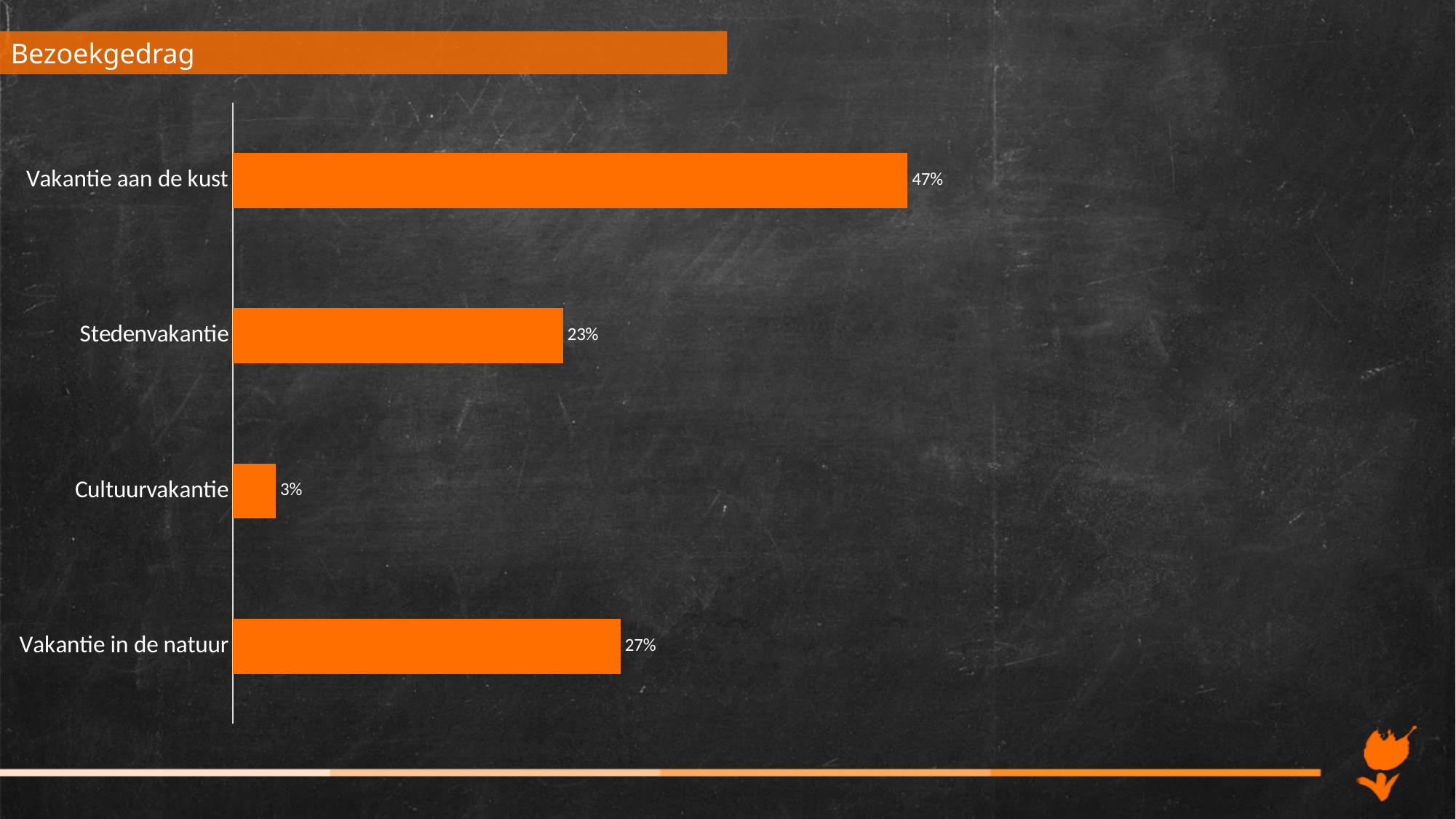
What is the value for Stedenvakantie? 23% What is the difference between the values for Vakantie in de natuur and Cultuurvakantie? 24% What is the title shown at the top of the slide? Bezoekgedrag Which is larger, the value for Vakantie in de natuur or the value for Stedenvakantie? Vakantie in de natuur Which category has the highest value? Vakantie aan de kust Which category has the lowest value? Cultuurvakantie What is the value for Cultuurvakantie? 3% What is the value for Vakantie aan de kust? 47% What is the value for Vakantie in de natuur? 27% What is the difference between the values for Vakantie aan de kust and Stedenvakantie? 24% How many categories are shown in the chart? 4 What kind of chart is shown on the slide? Bar chart